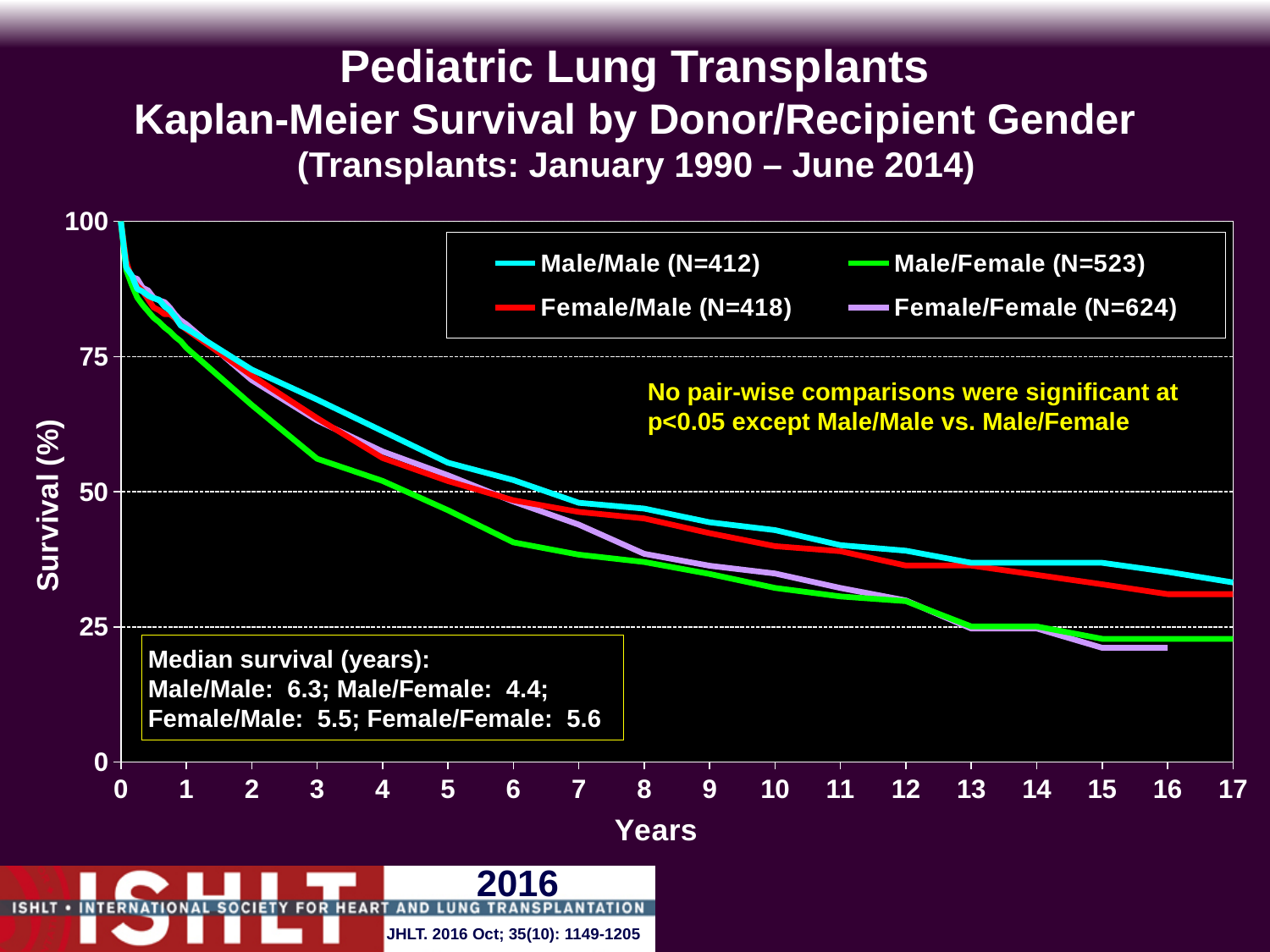
At 3 years, which group has higher survival, Male/Male or Male/Female? Male/Male What is the difference in median survival (years) between the Male/Male and Male/Female groups? 1.9 What kind of chart is shown on the slide? line chart Which donor/recipient gender group has the lowest median survival? Male/Female How many transplants (N) are in the Female/Female group according to the legend? 624 What is the median survival in years for the Male/Female group? 4.4 Is the survival value for Male/Male at 10 years greater or less than 50? less What is the median survival in years for the Female/Female group? 5.6 Which donor/recipient gender group has the highest median survival? Male/Male Is the survival value for Female/Female at 15 years greater or less than 25? less How many series does the legend list? 4 What is the median survival in years for the Male/Male group? 6.3